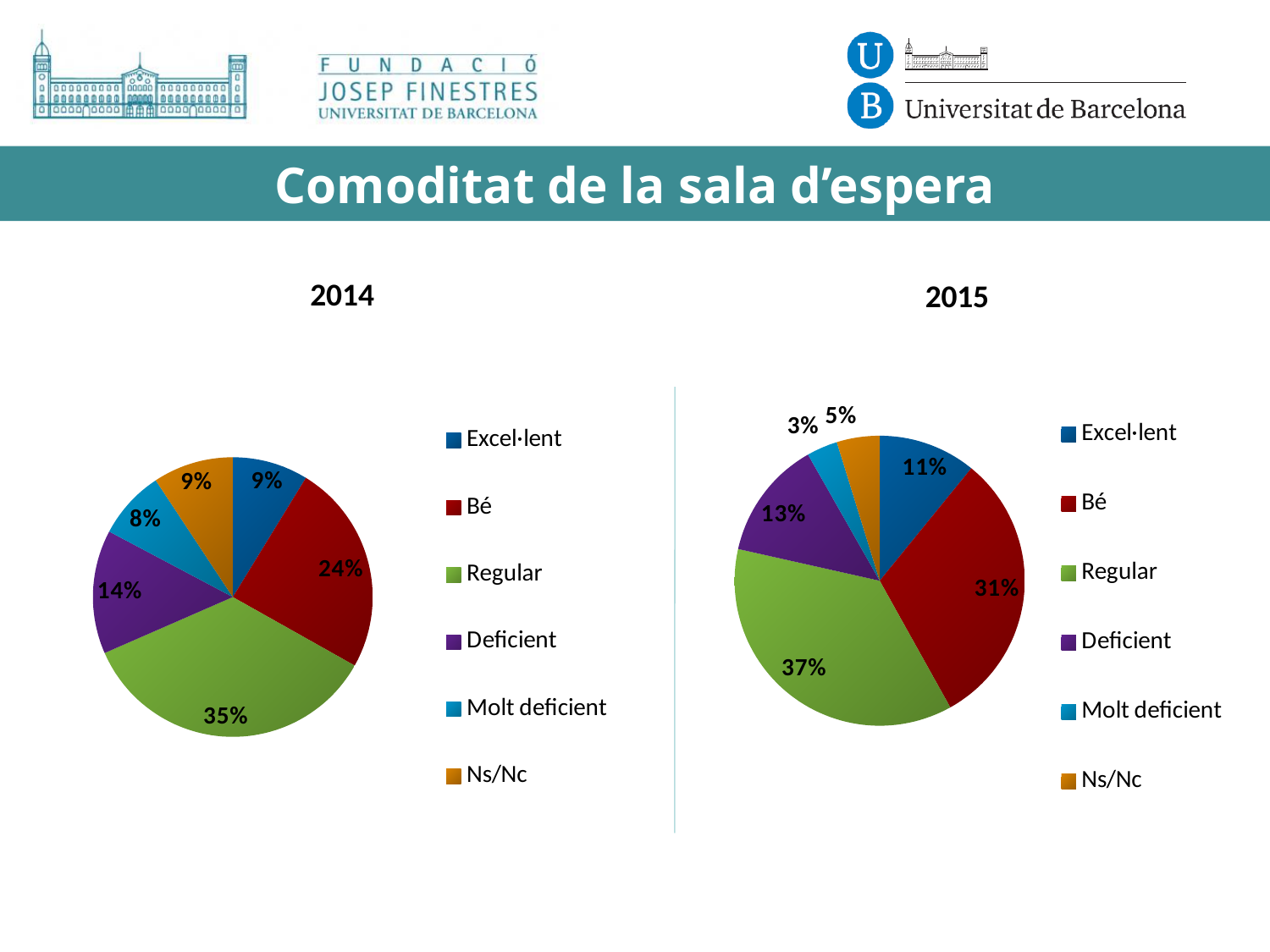
In the 2015 pie chart, which category has the smallest share? Molt deficient Which is larger: the Excel·lent share in the 2014 pie chart or in the 2015 pie chart? 2015 How many categories does the 2014 pie chart show? 6 In the 2014 pie chart, what share does Deficient have? 14% What is the difference between the Bé share in the 2015 pie chart and the Bé share in the 2014 pie chart? 7% What is the title of the slide containing the two pie charts? Comoditat de la sala d'espera In the 2014 pie chart, which category has the smallest share? Molt deficient In the 2015 pie chart, what share does Bé have? 31% In the 2015 pie chart, which category has the largest share? Regular In the 2014 pie chart, what share does Regular have? 35% What type of chart is used for the 2015 data? Pie chart In the 2015 pie chart, what share does Molt deficient have? 3%